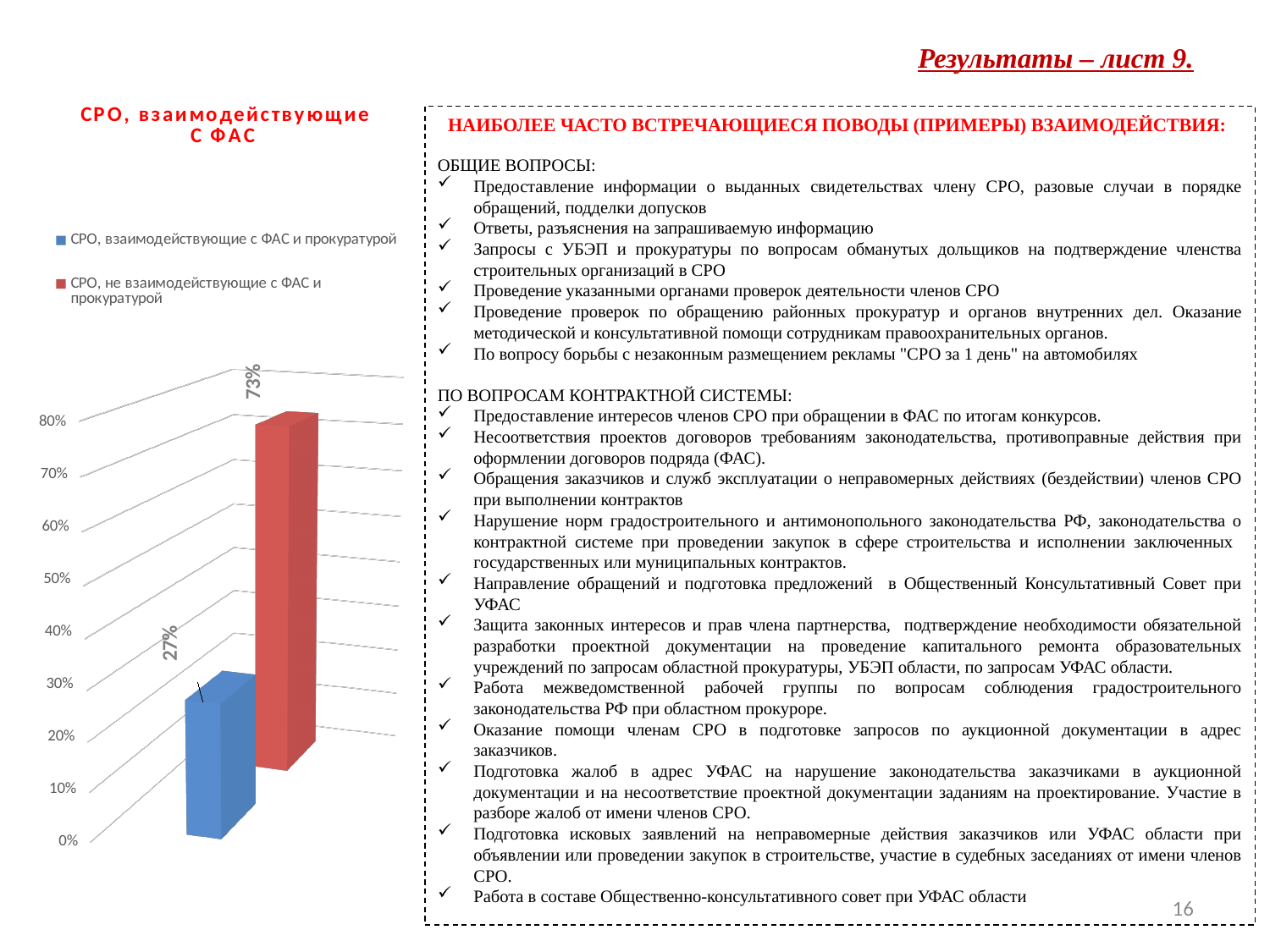
What colour is the bar for 'СРО, не взаимодействующие с ФАС и прокуратурой'? red How many series does the legend list? 2 What is the value for 'СРО, взаимодействующие с ФАС и прокуратурой'? 27% Which series has the higher value? СРО, не взаимодействующие с ФАС и прокуратурой What is the title of the chart? СРО, взаимодействующие с ФАС What is the difference between the values for 'СРО, не взаимодействующие с ФАС и прокуратурой' and 'СРО, взаимодействующие с ФАС и прокуратурой'? 46% What is the value for 'СРО, не взаимодействующие с ФАС и прокуратурой'? 73% Is the value for 'СРО, не взаимодействующие с ФАС и прокуратурой' greater or less than 50%? greater What kind of chart is shown on the slide? bar chart Which series has the lower value? СРО, взаимодействующие с ФАС и прокуратурой Is the value for 'СРО, взаимодействующие с ФАС и прокуратурой' larger or smaller than the value for 'СРО, не взаимодействующие с ФАС и прокуратурой'? smaller Is the value for 'СРО, взаимодействующие с ФАС и прокуратурой' greater or less than 40%? less